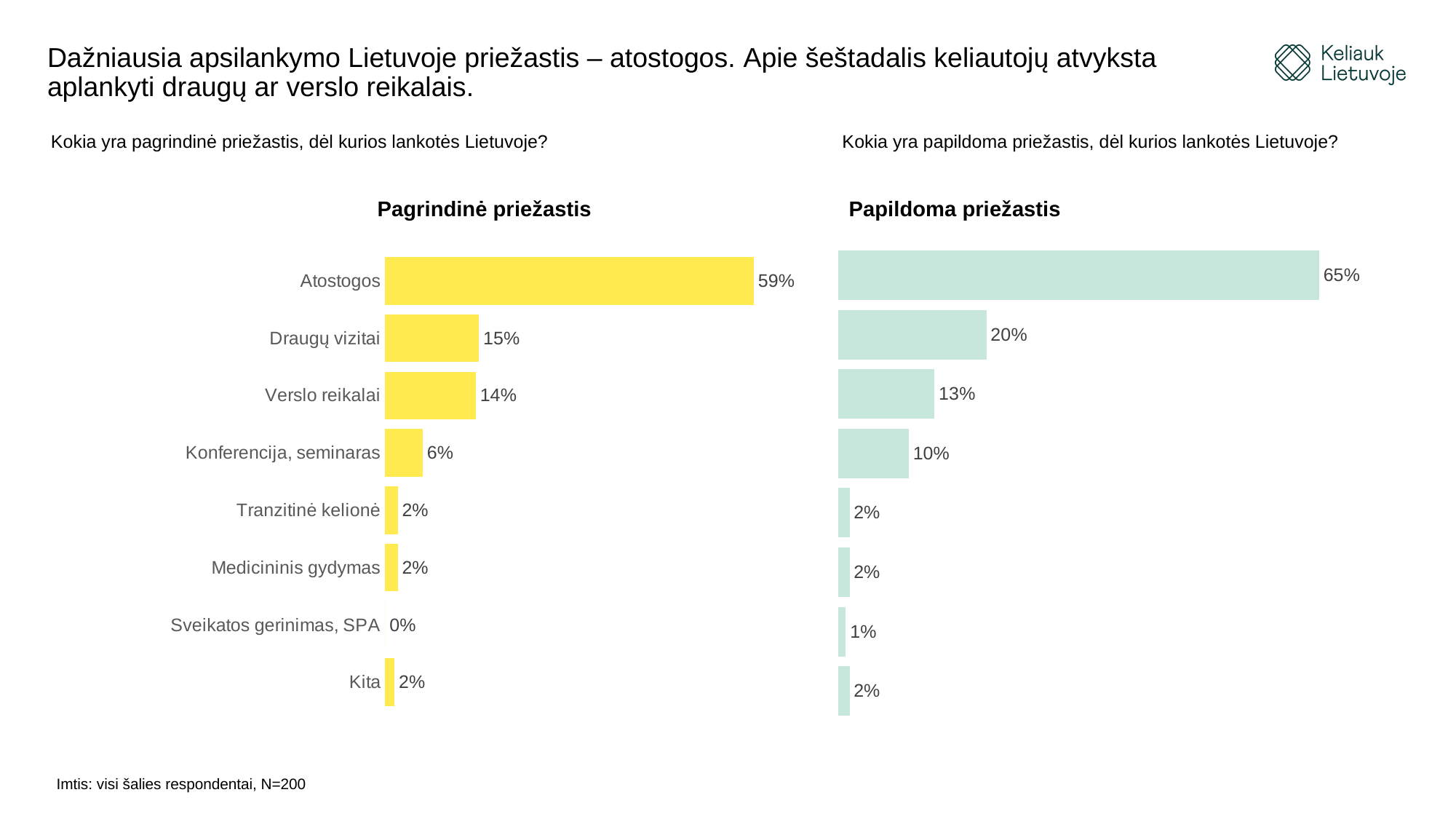
What type of chart is the 'Pagrindinė priežastis' chart? Bar chart In the 'Pagrindinė priežastis' chart, which category has the lowest value? Sveikatos gerinimas, SPA In the 'Pagrindinė priežastis' chart, what is the value for Atostogos? 59% In the 'Papildoma priežastis' chart, what is the value of the top (largest) bar? 65% In the 'Pagrindinė priežastis' chart, what is the value for Konferencija, seminaras? 6% In the 'Pagrindinė priežastis' chart, which category has the highest value? Atostogos In the 'Pagrindinė priežastis' chart, what is the difference between Draugų vizitai and Verslo reikalai? 1% In the 'Papildoma priežastis' chart, what is the difference between the top bar (65%) and the second bar (20%)? 45% In the 'Pagrindinė priežastis' chart, what is the value for Draugų vizitai? 15% In the 'Papildoma priežastis' chart, what is the value of the second bar from the top? 20% In the 'Pagrindinė priežastis' chart, how many categories are shown? 8 Which is larger: the Atostogos value in the 'Pagrindinė priežastis' chart or the top bar in the 'Papildoma priežastis' chart? Papildoma priežastis (65%)